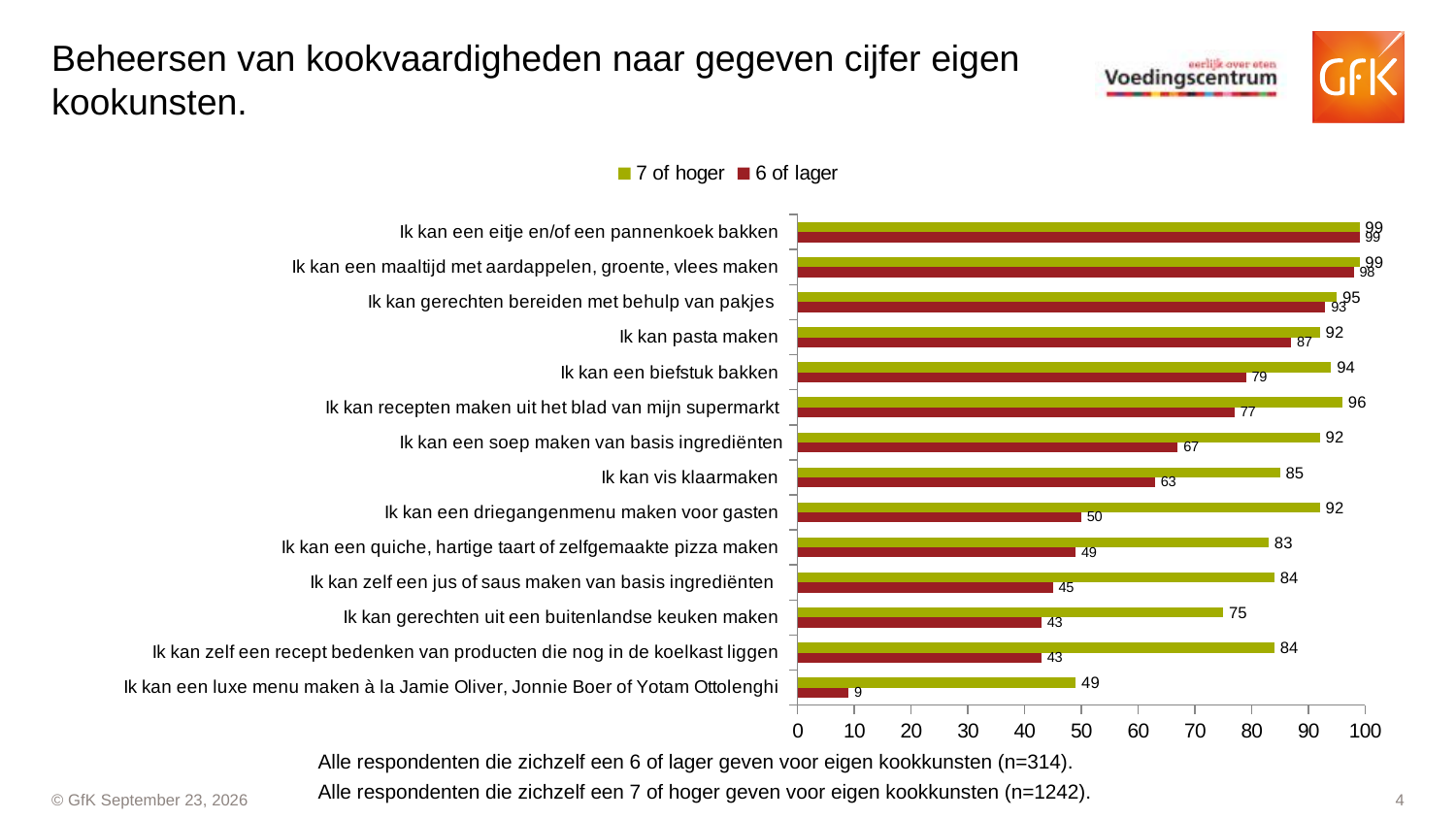
What is the difference between the '7 of hoger' and '6 of lager' values for 'Ik kan vis klaarmaken'? 22 Which category has the lowest value for the '7 of hoger' series? Ik kan een luxe menu maken à la Jamie Oliver, Jonnie Boer of Yotam Ottolenghi How many categories (cooking skills) are shown in the chart? 14 What is the difference between the '7 of hoger' and '6 of lager' values for 'Ik kan een soep maken van basis ingrediënten'? 25 How many series does the legend list? 2 What is the value for '6 of lager' for 'Ik kan een driegangenmenu maken voor gasten'? 50 What is the value for '6 of lager' for 'Ik kan een luxe menu maken à la Jamie Oliver, Jonnie Boer of Yotam Ottolenghi'? 9 Which is larger: the '6 of lager' value for 'Ik kan pasta maken' or the '6 of lager' value for 'Ik kan een biefstuk bakken'? Ik kan pasta maken Which series is shown in green in the chart? 7 of hoger What is the value for '7 of hoger' for 'Ik kan een biefstuk bakken'? 94 What type of chart is shown on the slide? bar chart What is the value for '7 of hoger' for 'Ik kan gerechten uit een buitenlandse keuken maken'? 75